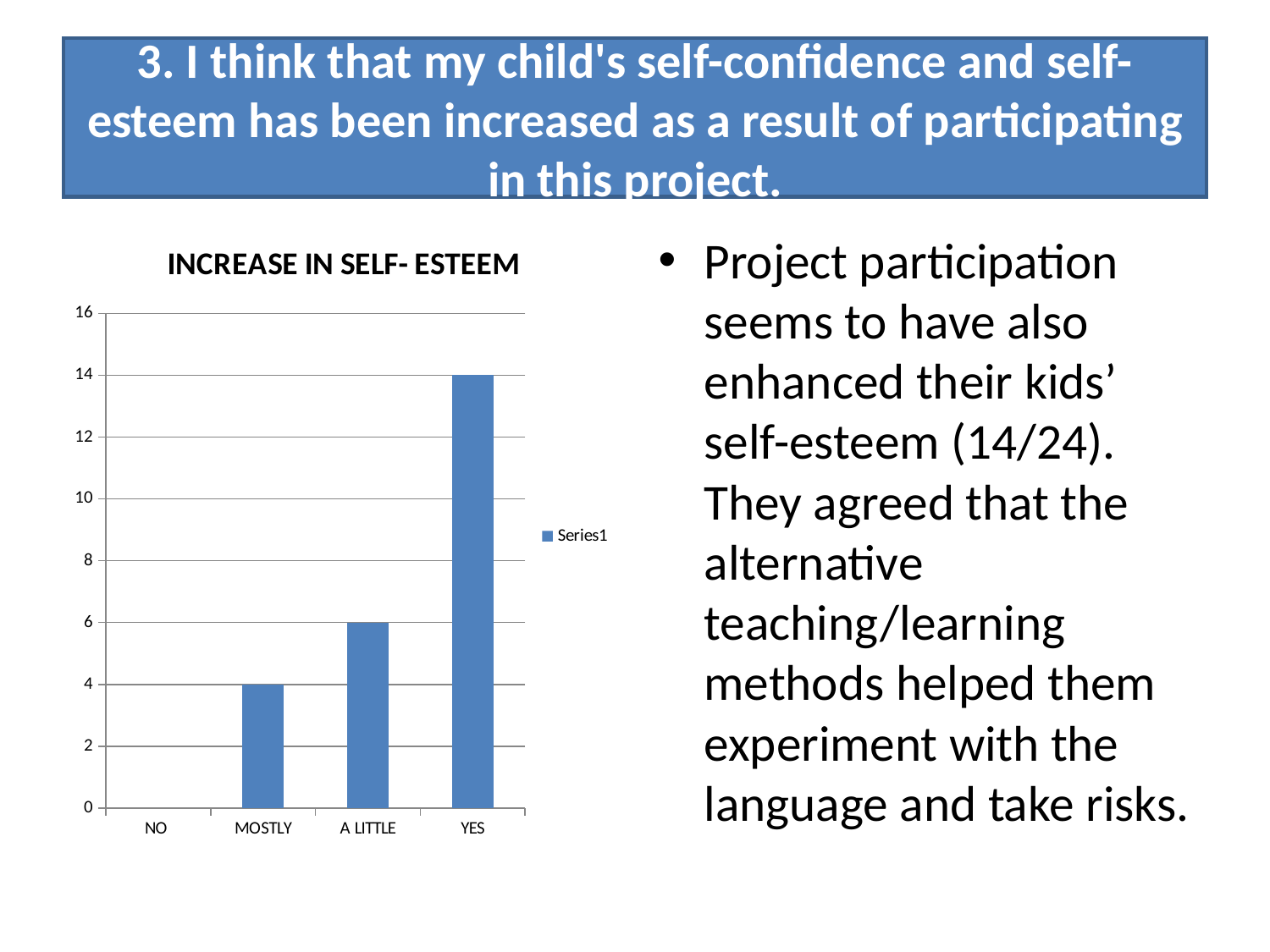
What is the difference between the values for YES and MOSTLY? 10 What is the value for MOSTLY? 4 Which category has the highest value? YES Which category has the lowest value? NO What is the value for A LITTLE? 6 What is the title of the chart? INCREASE IN SELF- ESTEEM What is the value for YES? 14 Which is larger, the value for MOSTLY or the value for A LITTLE? A LITTLE What type of chart is shown on the slide? bar chart How many series does the legend list? 1 What is the difference between the values for YES and A LITTLE? 8 How many categories are shown on the x axis? 4